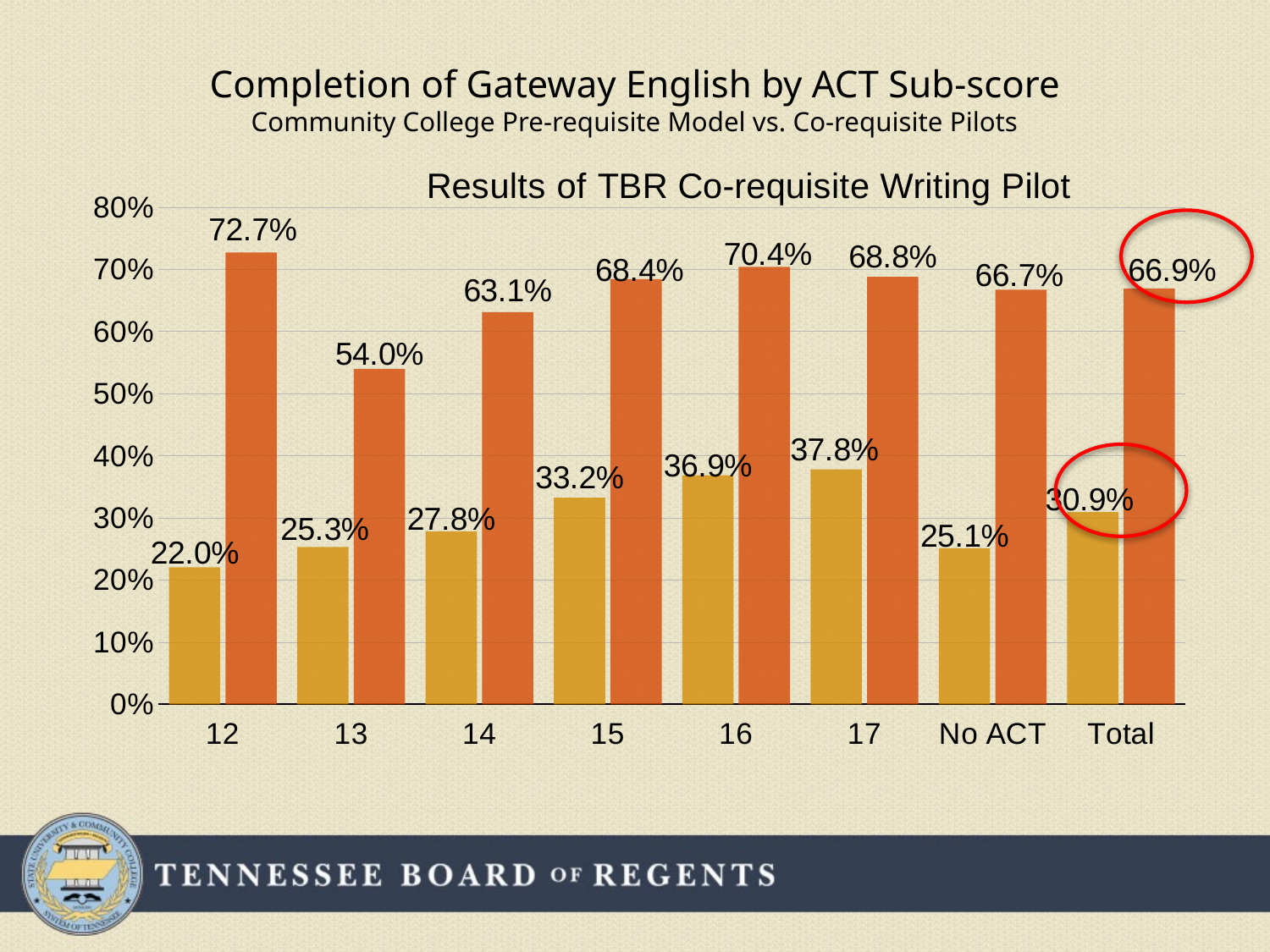
What is the value of the orange bar for ACT sub-score 12? 72.7% Which is larger: the gold bar for ACT sub-score 15 or the gold bar for ACT sub-score 14? ACT sub-score 15 What is the title of the chart? Results of TBR Co-requisite Writing Pilot What kind of chart is shown on the slide? Bar chart What is the value of the orange bar for ACT sub-score 16? 70.4% What is the difference between the orange bar and the gold bar for the Total category? 36.0% Which category has the lowest value among the orange bars? 13 What is the value of the gold bar for the Total category? 30.9% Which category has the highest value among the gold bars? 17 Do the gold bars rise or fall from ACT sub-score 12 to 17? Rise How many categories are shown on the x axis? 8 What is the value of the gold bar for the No ACT category? 25.1%